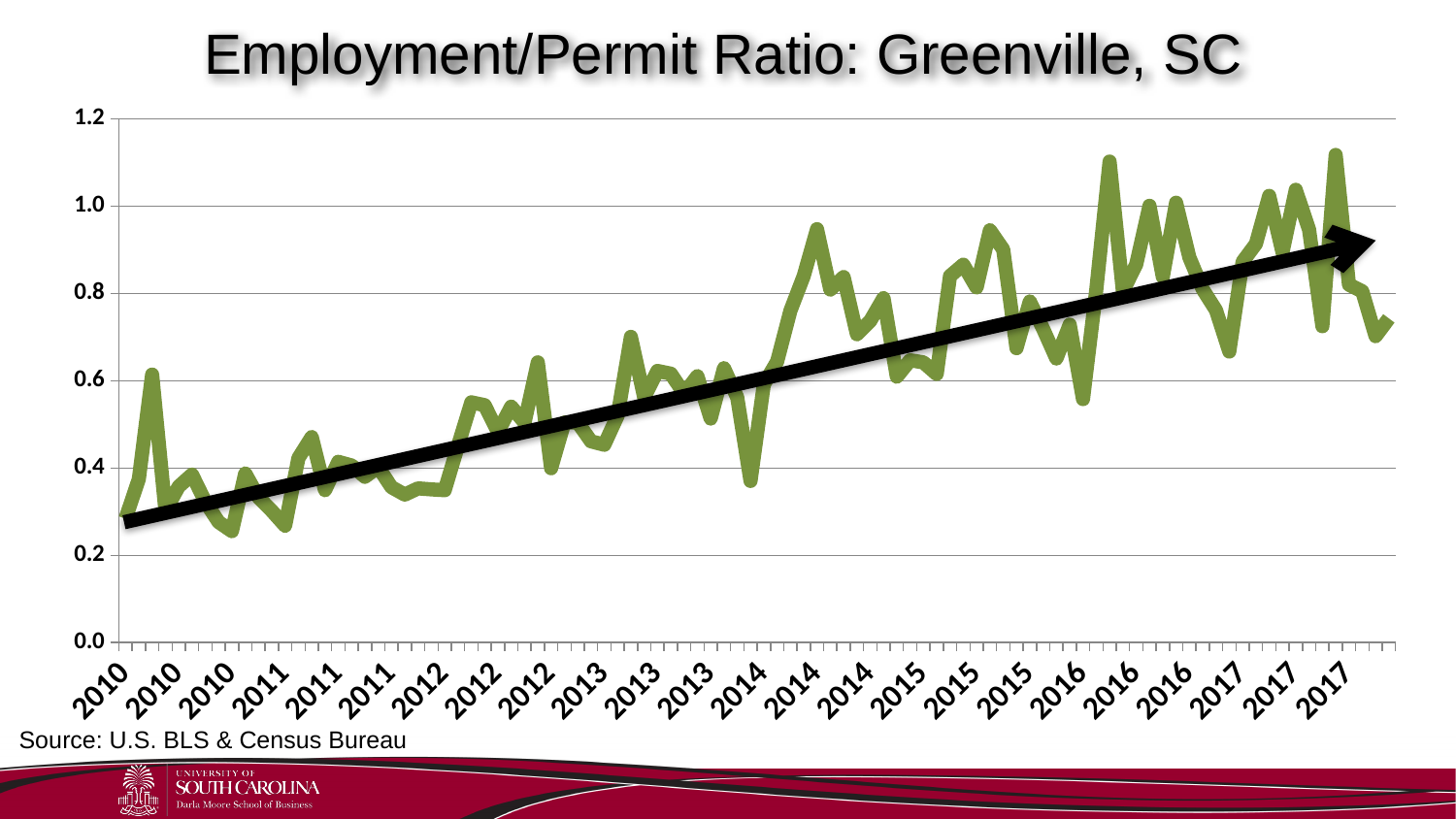
What kind of chart is shown on the slide? line chart Is the last plotted value in 2017 greater or less than 0.6? greater Is the highest plotted value on the chart greater or less than 1.2? less Which is higher, the first plotted value in 2010 or the last plotted value in 2017? the last value in 2017 Is the last plotted value in 2017 greater or less than 1.0? less What is the maximum value shown on the y axis? 1.2 How many distinct years are labelled on the x axis? 8 Do the plotted values generally rise or fall from 2010 to 2017? rise Which direction does the thick black arrow drawn over the line point? upward to the right What is the title of the chart? Employment/Permit Ratio: Greenville, SC